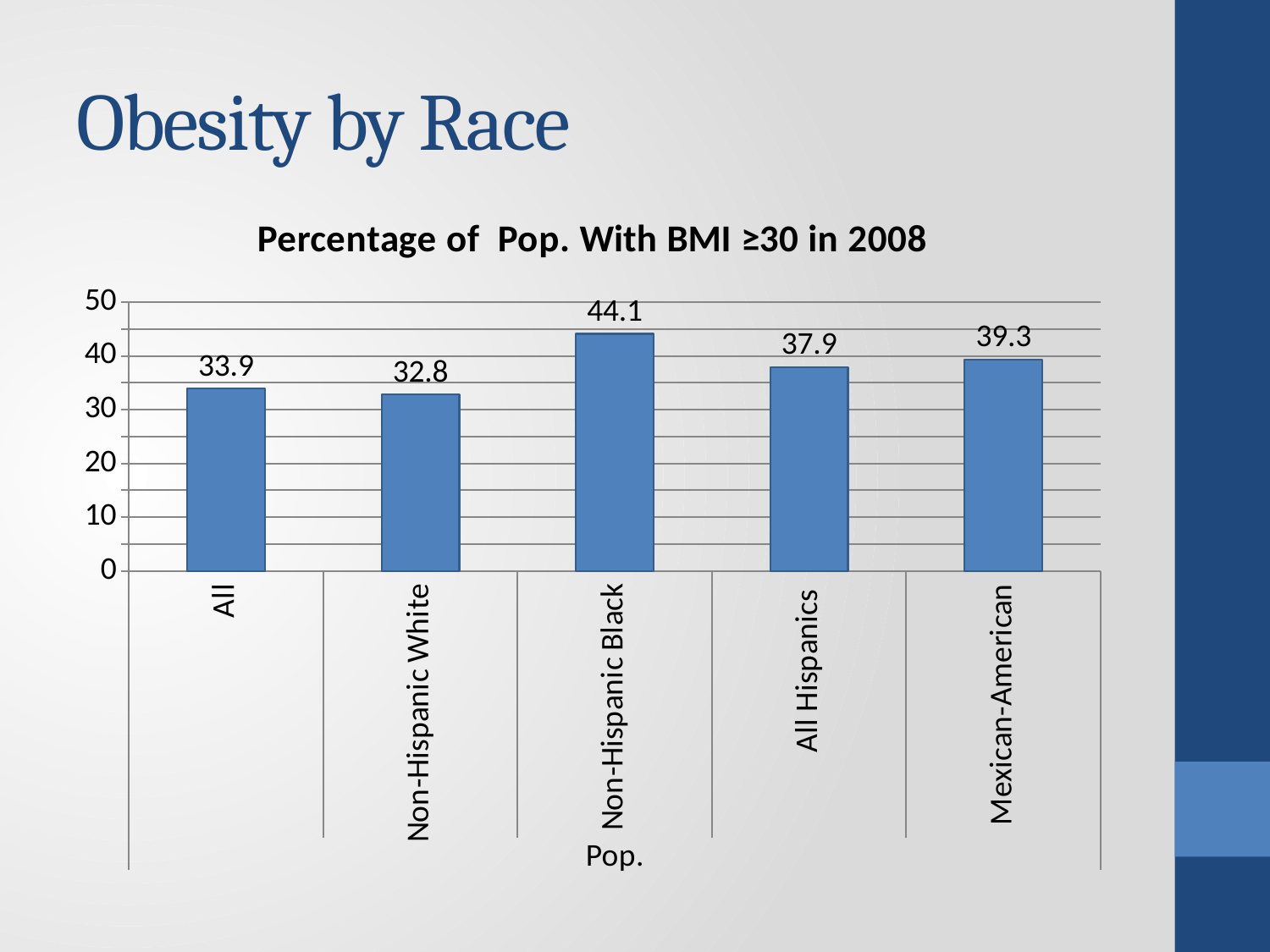
What is the difference between the values for Non-Hispanic Black and Non-Hispanic White? 11.3 What is the value for Non-Hispanic Black? 44.1 What is the value for All Hispanics? 37.9 How many categories are shown on the x axis? 5 What is the value for Mexican-American? 39.3 Which category has the lowest value? Non-Hispanic White What is the title of the chart? Percentage of Pop. With BMI ≥30 in 2008 Is the value for Non-Hispanic Black greater or less than 40? greater Which category has the highest value? Non-Hispanic Black What is the value for the All category? 33.9 What kind of chart is shown on the slide? bar chart Which is larger, the value for Mexican-American or the value for All Hispanics? Mexican-American